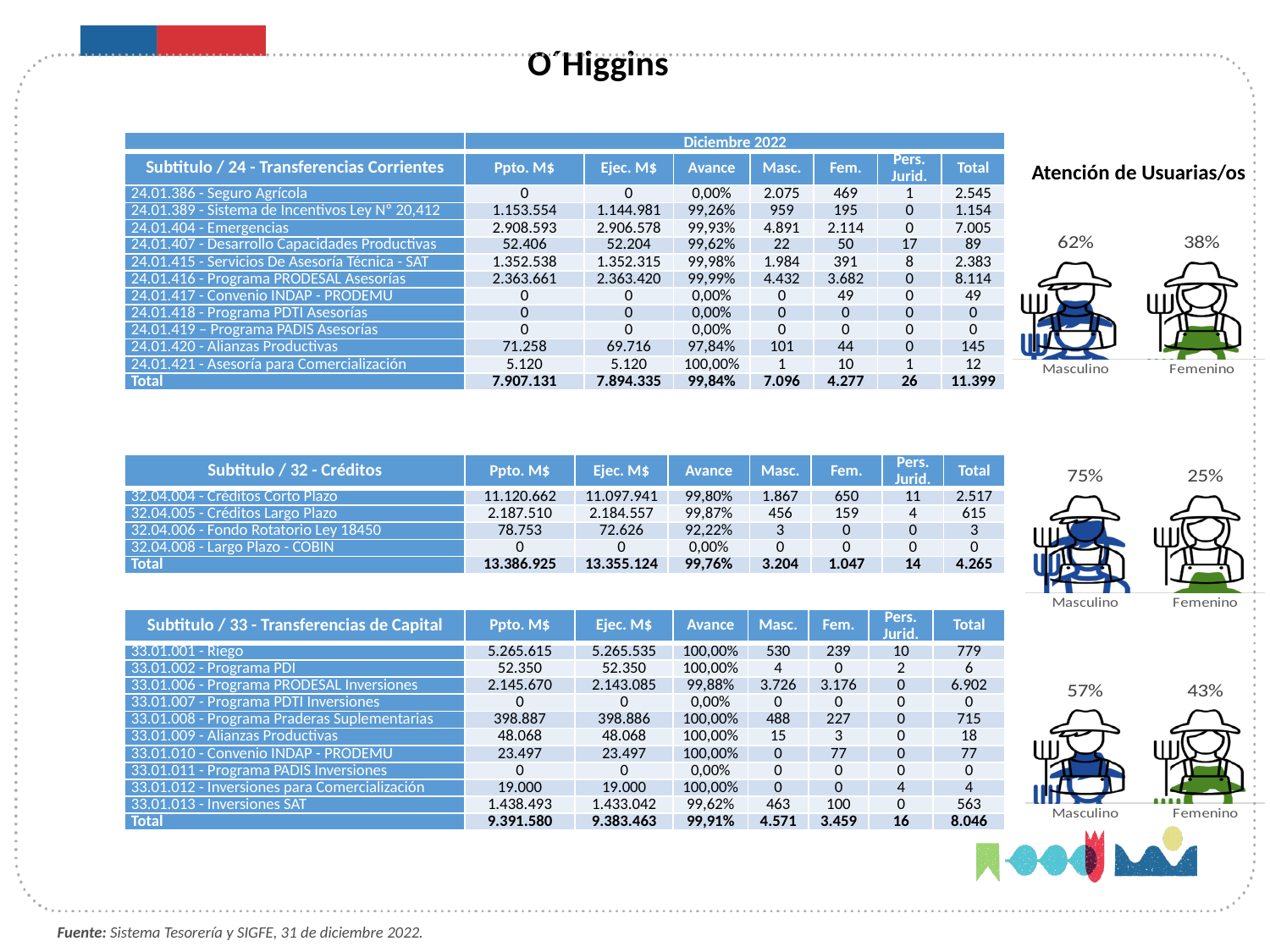
In the middle pictogram (next to Subtítulo 32 - Créditos), what percentage is shown for Femenino? 25% In the bottom pictogram (next to Subtítulo 33), which category is larger, Masculino or Femenino? Masculino What is the title above the pictograms on the right side of the slide? Atención de Usuarias/os In the middle pictogram (next to Subtítulo 32 - Créditos), what is the difference between the Masculino and Femenino percentages? 50% Across the three pictograms on the right, which one shows the highest Masculino percentage? The middle one (Subtítulo 32 - Créditos), 75% In the top 'Atención de Usuarias/os' pictogram (next to Subtítulo 24), what percentage is shown for Femenino? 38% Across the three pictograms on the right, which one shows the lowest Femenino percentage? The middle one (Subtítulo 32 - Créditos), 25% In the bottom pictogram (next to Subtítulo 33 - Transferencias de Capital), what percentage is shown for Femenino? 43% In the middle pictogram (next to Subtítulo 32 - Créditos), what percentage is shown for Masculino? 75% How many categories does each pictogram on the right show? 2 In the top 'Atención de Usuarias/os' pictogram (next to Subtítulo 24), what percentage is shown for Masculino? 62% In the bottom pictogram (next to Subtítulo 33 - Transferencias de Capital), what percentage is shown for Masculino? 57%